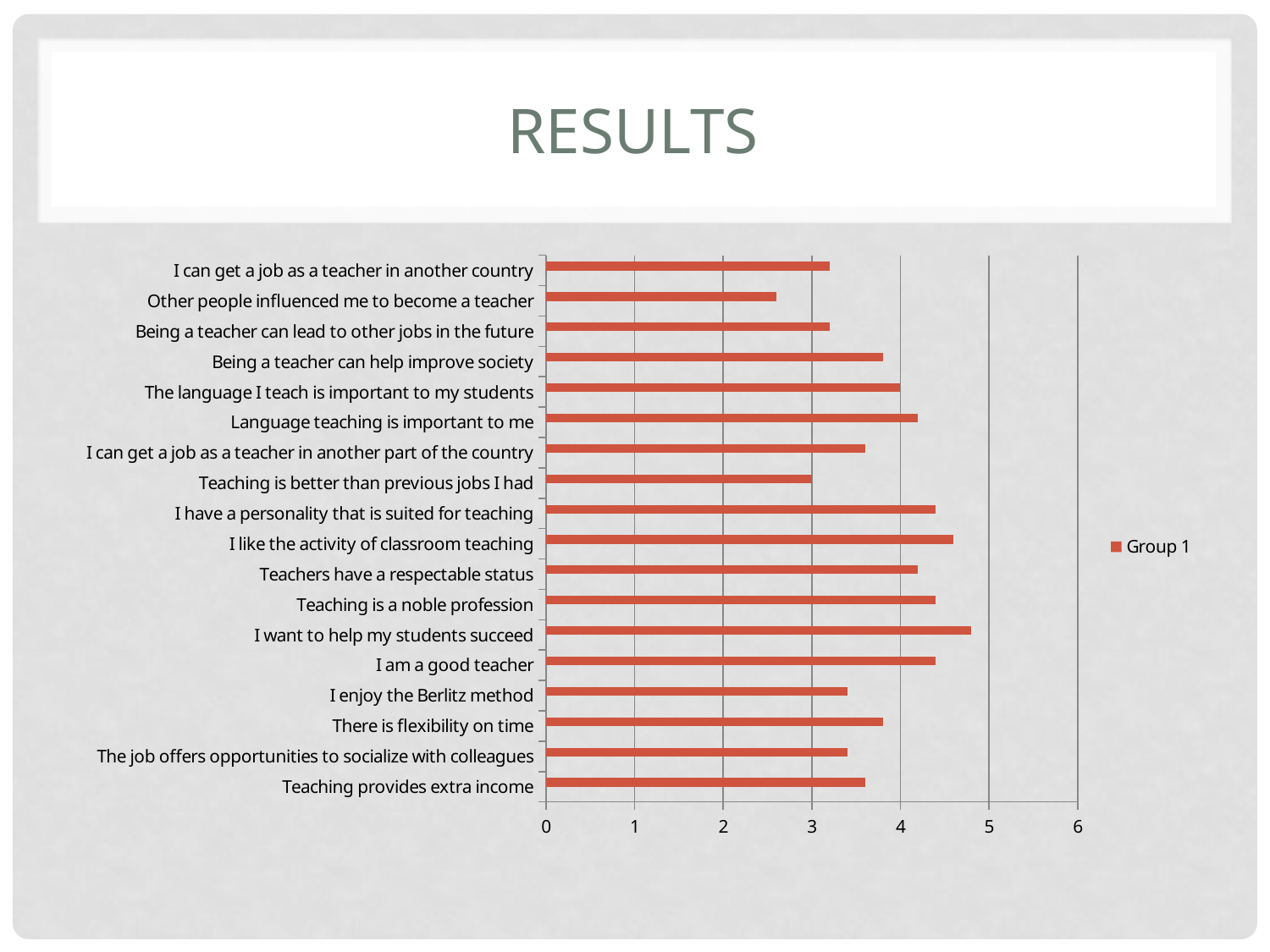
What kind of chart is shown on the slide? bar chart Is the value for "Language teaching is important to me" greater or less than 4? greater Is the value for "I enjoy the Berlitz method" greater or less than 4? less Which has the larger value: "I like the activity of classroom teaching" or "Teaching is better than previous jobs I had"? I like the activity of classroom teaching How many series does the legend list? 1 Which has the larger value: "Teaching provides extra income" or "Other people influenced me to become a teacher"? Teaching provides extra income Which statement has the highest value in the chart? I want to help my students succeed How many categories (statements) are plotted in the chart? 18 Is the value for "I want to help my students succeed" greater or less than 4? greater Which statement has the lowest value in the chart? Other people influenced me to become a teacher What is the name of the series shown in the legend? Group 1